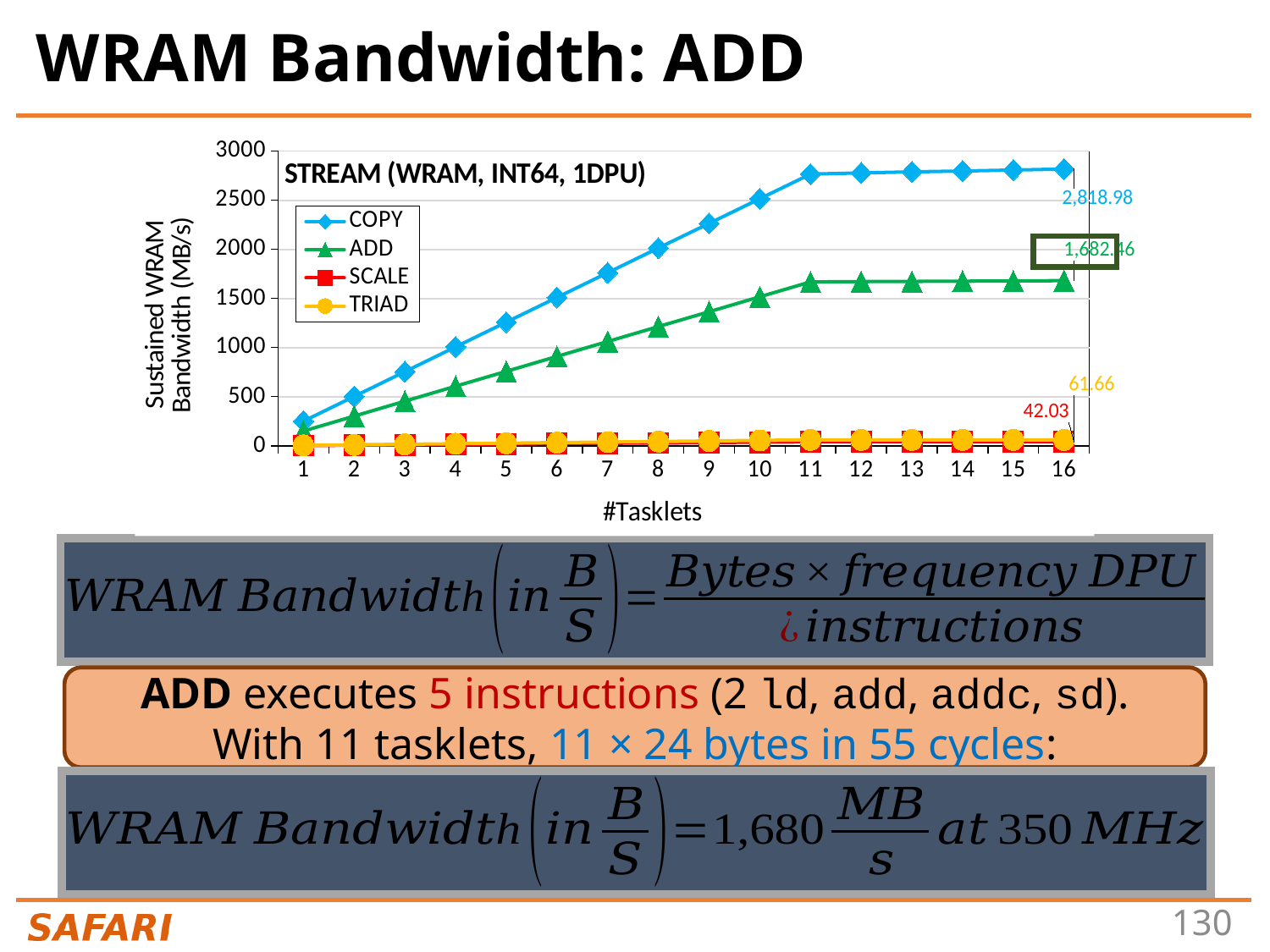
What is the labelled SCALE bandwidth at 16 tasklets? 42.03 What is the difference between the TRIAD and SCALE labelled values at 16 tasklets? 19.63 What kind of chart is shown on the slide? line chart What is the labelled COPY bandwidth at 16 tasklets? 2,818.98 How many series does the chart legend list? 4 Is the COPY value at 5 tasklets greater or less than 1000? greater What is the labelled TRIAD bandwidth at 16 tasklets? 61.66 Which series has the highest bandwidth at 16 tasklets? COPY Does the ADD bandwidth rise or fall as #Tasklets increases from 1 to 11? rise How many #Tasklets values are plotted along the x axis? 16 At 16 tasklets, which is larger: COPY or ADD? COPY Which series has the lowest bandwidth at 16 tasklets? SCALE